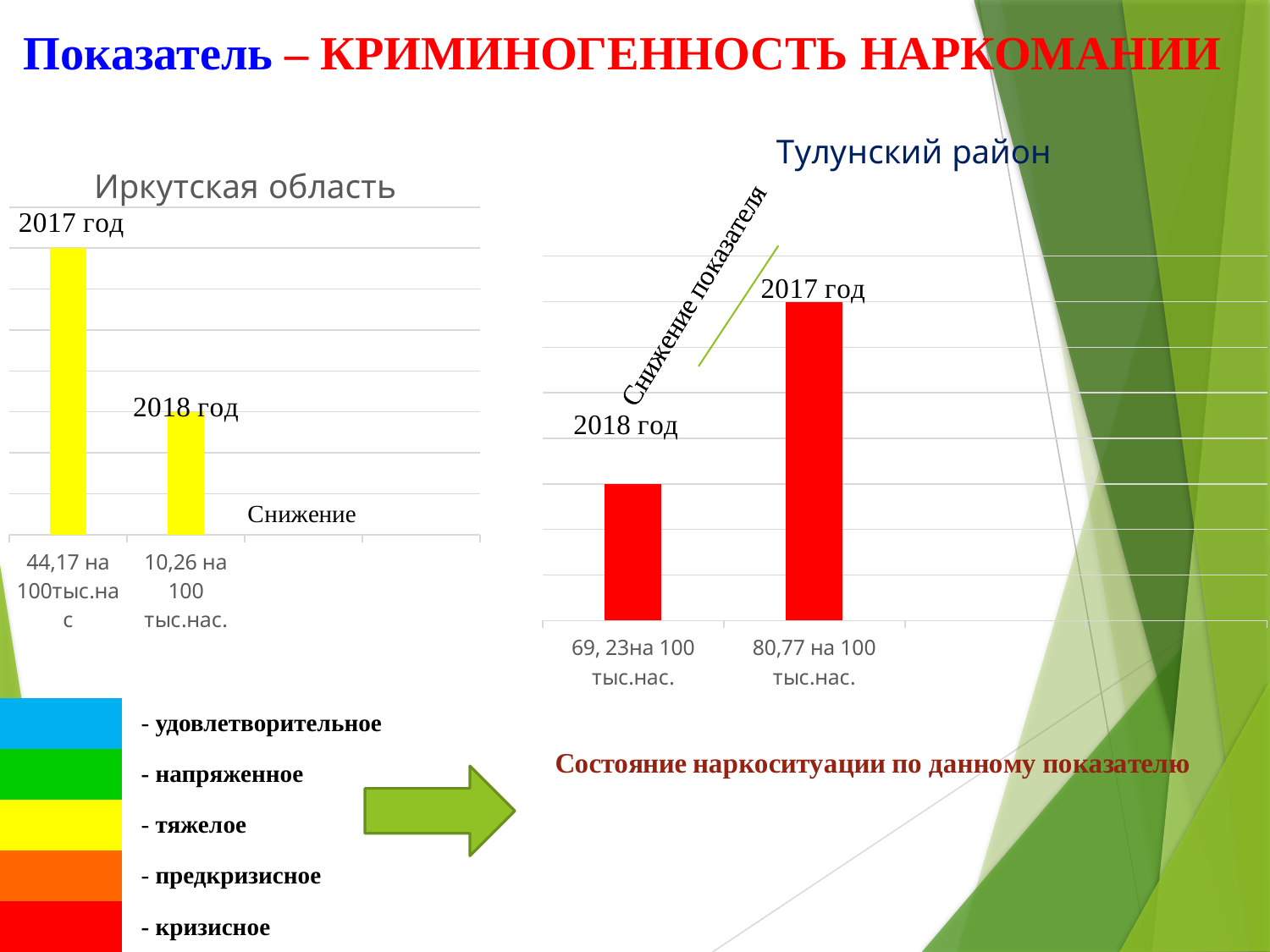
On the chart titled "Иркутская область", which year has the higher bar? 2017 год On the chart titled "Иркутская область", by how much did the value fall from 2017 год to 2018 год? 33,91 What kind of chart is the one titled "Иркутская область"? Bar chart Comparing the 2018 год values, which chart shows the larger value: "Иркутская область" or "Тулунский район"? Тулунский район On the chart titled "Тулунский район", what value is shown for 2017 год? 80,77 на 100 тыс.нас. On the chart titled "Тулунский район", which year has the lower bar? 2018 год On the chart titled "Иркутская область", what value is shown for 2018 год? 10,26 на 100 тыс.нас. On the chart titled "Тулунский район", what is the difference between the 2017 год and 2018 год values? 11,54 What colour are the bars on the chart titled "Тулунский район"? Red How many bars are plotted on the chart titled "Тулунский район"? 2 On the chart titled "Иркутская область", what value is shown for 2017 год? 44,17 на 100 тыс.нас. On the chart titled "Тулунский район", what value is shown for 2018 год? 69,23 на 100 тыс.нас.